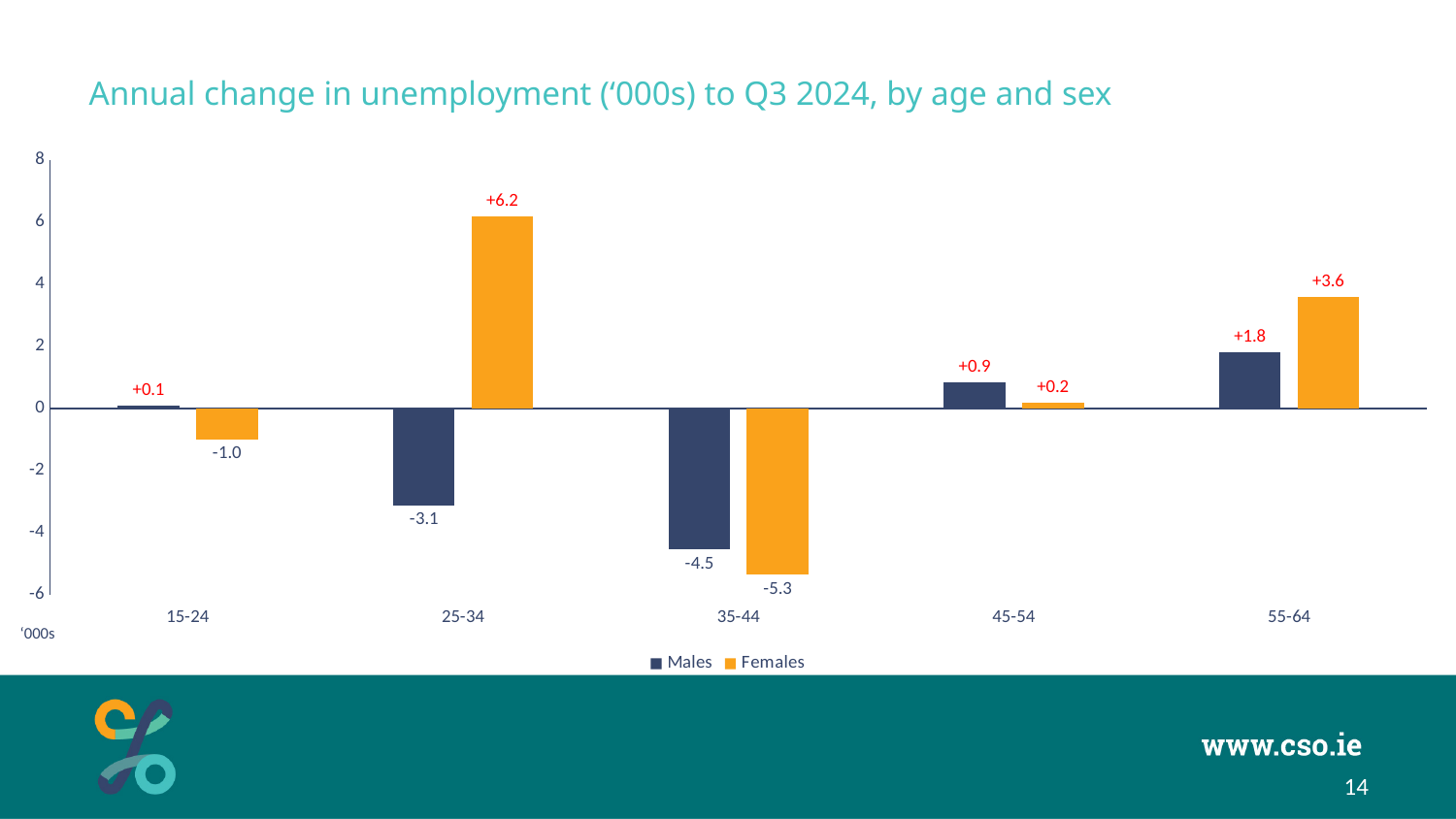
What is the annual change in unemployment for Males aged 55-64? +1.8 What colour are the Females bars? Orange How many series does the legend list? 2 For the 45-54 age group, which is larger: the Males value or the Females value? Males Which age group has the lowest annual change in unemployment for Males? 35-44 What kind of chart is shown on the slide? Bar chart What is the annual change in unemployment for Males aged 35-44? -4.5 What is the difference between the Females and Males values for the 55-64 age group? 1.8 How many age groups are shown on the x axis? 5 Which age group has the highest annual change in unemployment for Females? 25-34 What is the annual change in unemployment for Females aged 25-34? +6.2 What is the annual change in unemployment for Females aged 15-24? -1.0